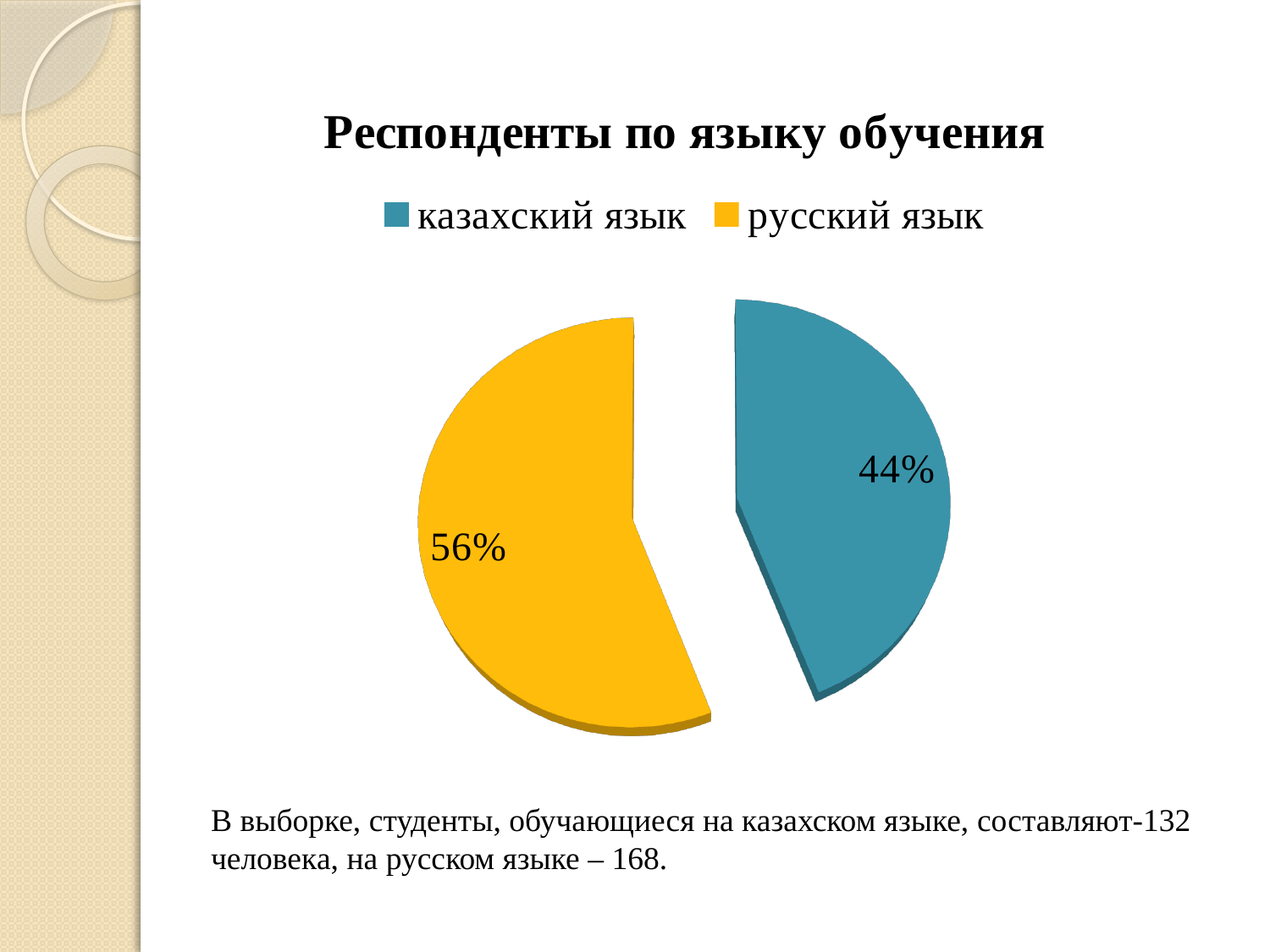
What colour is the 'русский язык' slice? yellow How many entries does the legend list? 2 What is the difference in percentage points between the 'русский язык' and 'казахский язык' slices? 12 What share of respondents does the 'русский язык' slice represent? 56% Which slice is larger, 'казахский язык' or 'русский язык'? русский язык How many slices does the pie chart have? 2 Which language of instruction has the largest share of respondents? русский язык What kind of chart is shown on the slide? pie chart What is the title of the chart? Респонденты по языку обучения Is the share for 'казахский язык' greater or less than 50%? less What share of respondents does the 'казахский язык' slice represent? 44% Which language of instruction has the smallest share of respondents? казахский язык